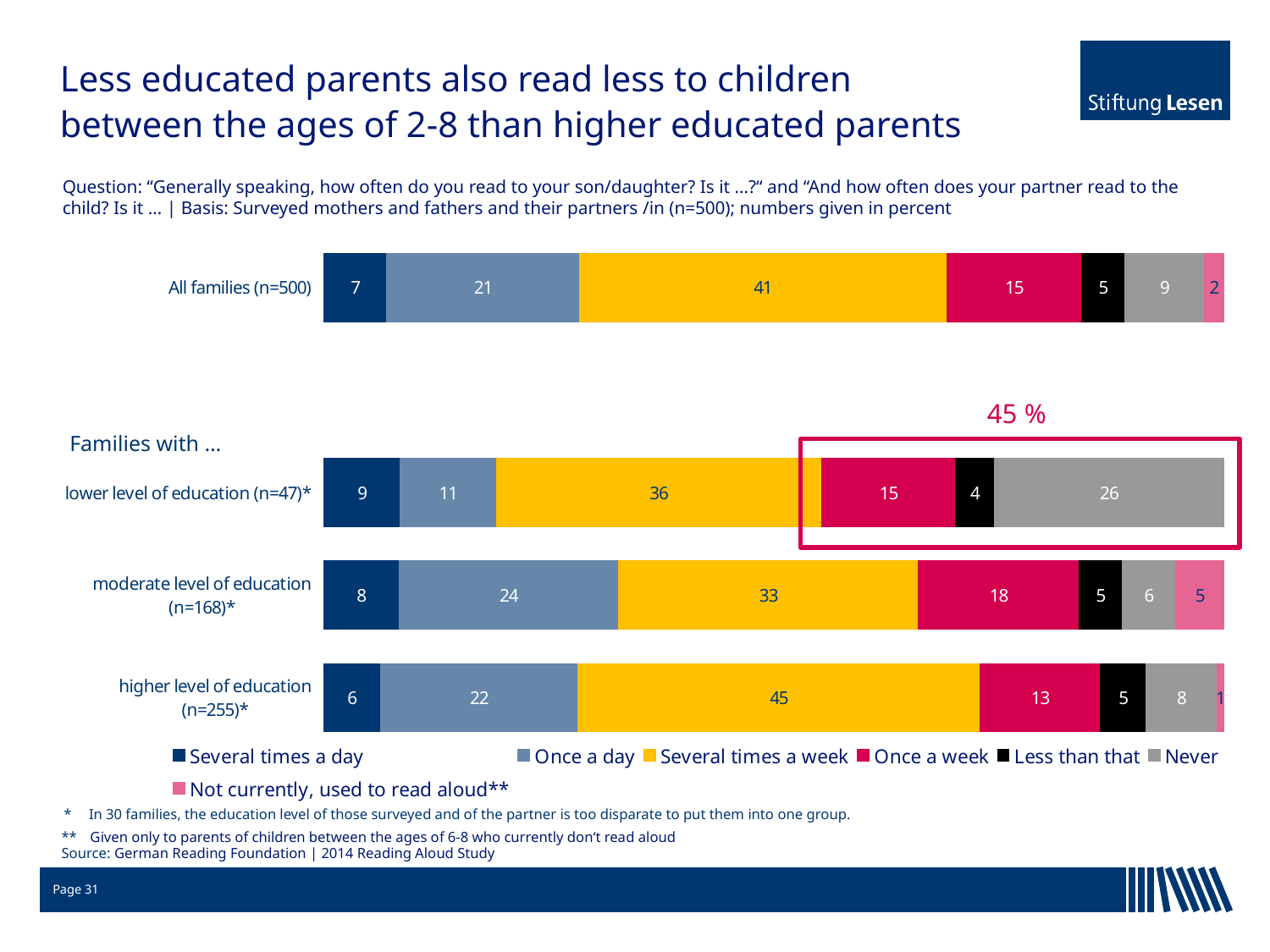
Which education group has the lowest value for 'Several times a day'? higher level of education (n=255)* What is the value for 'Once a day' for families with a moderate level of education (n=168)? 24 How many bars (categories) are shown in the chart? 4 Which is larger: the 'Once a week' value for moderate level of education or for higher level of education? moderate level of education What is the value for 'Never' for families with a lower level of education (n=47)? 26 How many series does the legend list? 7 Which education group has the highest value for 'Never'? lower level of education (n=47)* What is the value for 'Several times a week' for All families (n=500)? 41 What percentage is highlighted above the red box on the lower level of education bar? 45 % What kind of chart is shown on the slide? stacked bar chart What is the value for 'Several times a week' for families with a higher level of education (n=255)? 45 What is the difference between the 'Several times a week' values for higher level of education and lower level of education? 9